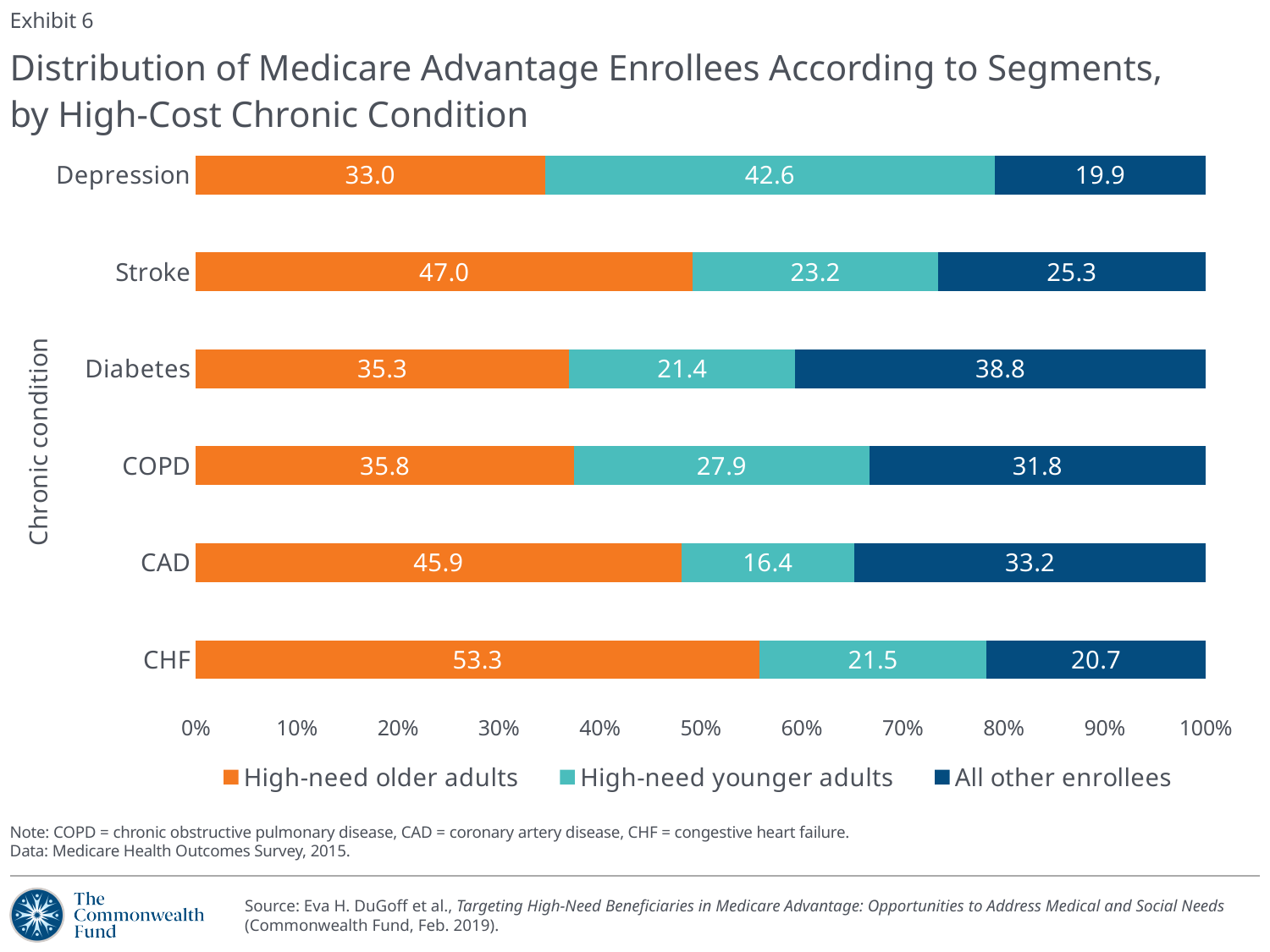
Which series is shown in orange? High-need older adults What is the value for High-need older adults for Stroke? 47.0 What kind of chart is shown? Stacked bar chart What is the difference between the High-need older adults values for CHF and Depression? 20.3 What is the value for All other enrollees for Diabetes? 38.8 How many chronic conditions are shown on the chart? 6 How many series does the legend list? 3 Which is larger for COPD: High-need younger adults or All other enrollees? All other enrollees What is the value for High-need younger adults for CAD? 16.4 What is the total of the three segments for Depression? 95.5 Which chronic condition has the highest value for High-need older adults? CHF Which chronic condition has the lowest value for High-need younger adults? CAD